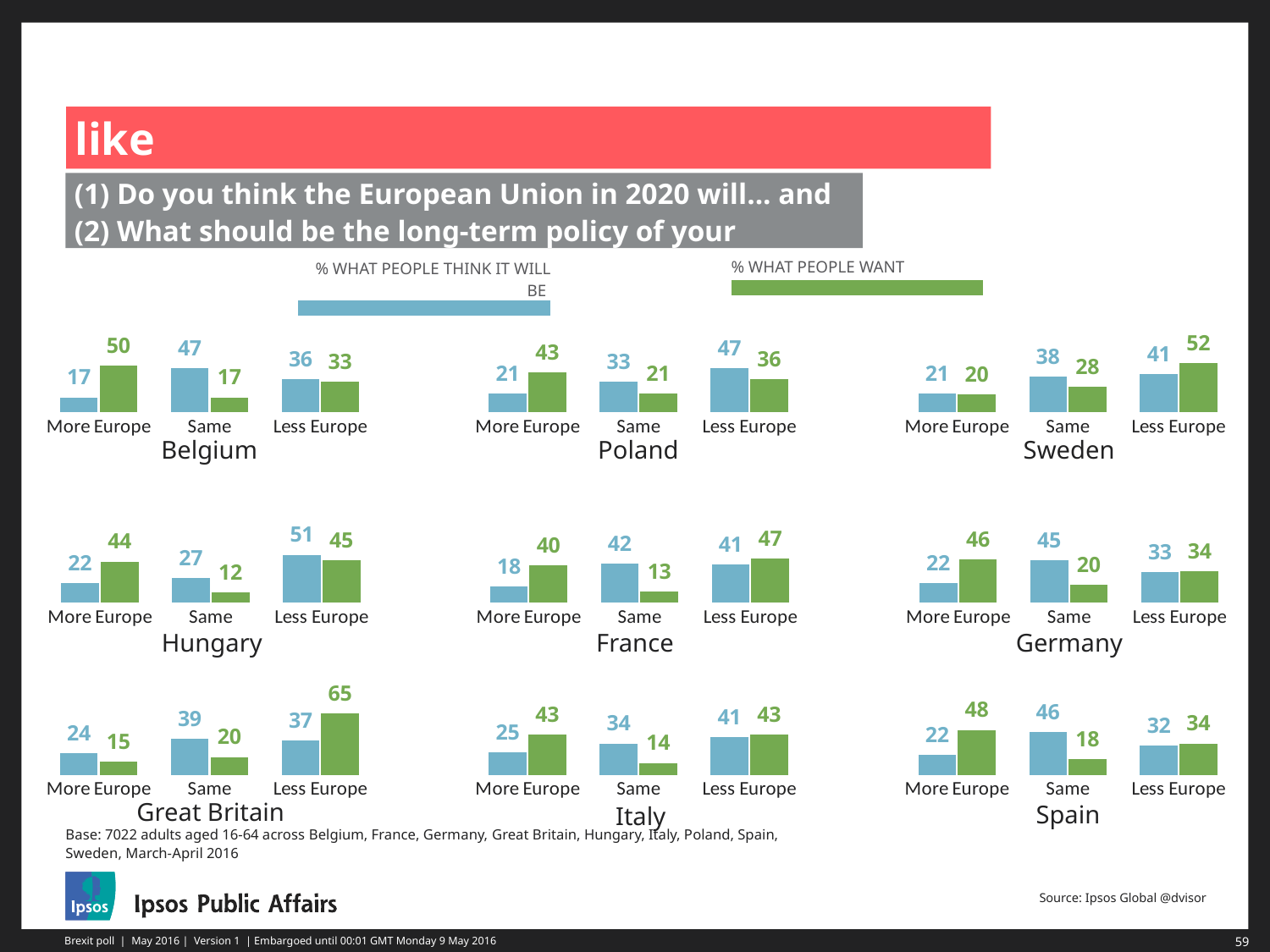
In the Hungary chart, which category has the highest value for what people think it will be? Less Europe In the Belgium chart, what percentage of people want More Europe? 50 In the Sweden chart, what percentage of people think it will be Less Europe? 41 How many categories are shown on the x axis of the Spain chart? 3 What type of chart is used for each country? Bar chart In the Great Britain chart, what percentage of people want Less Europe? 65 Which colour represents '% what people want' in the legend? Green How many series does the legend list? 2 In the France chart, which category has the lowest value for what people want? Same In the Germany chart, which is larger for Same: what people think it will be or what people want? What people think it will be In the Italy chart, what is the difference between what people want and what people think it will be for Same? 20 In the Poland chart, what is the difference between the share who want More Europe and the share who think it will be More Europe? 22